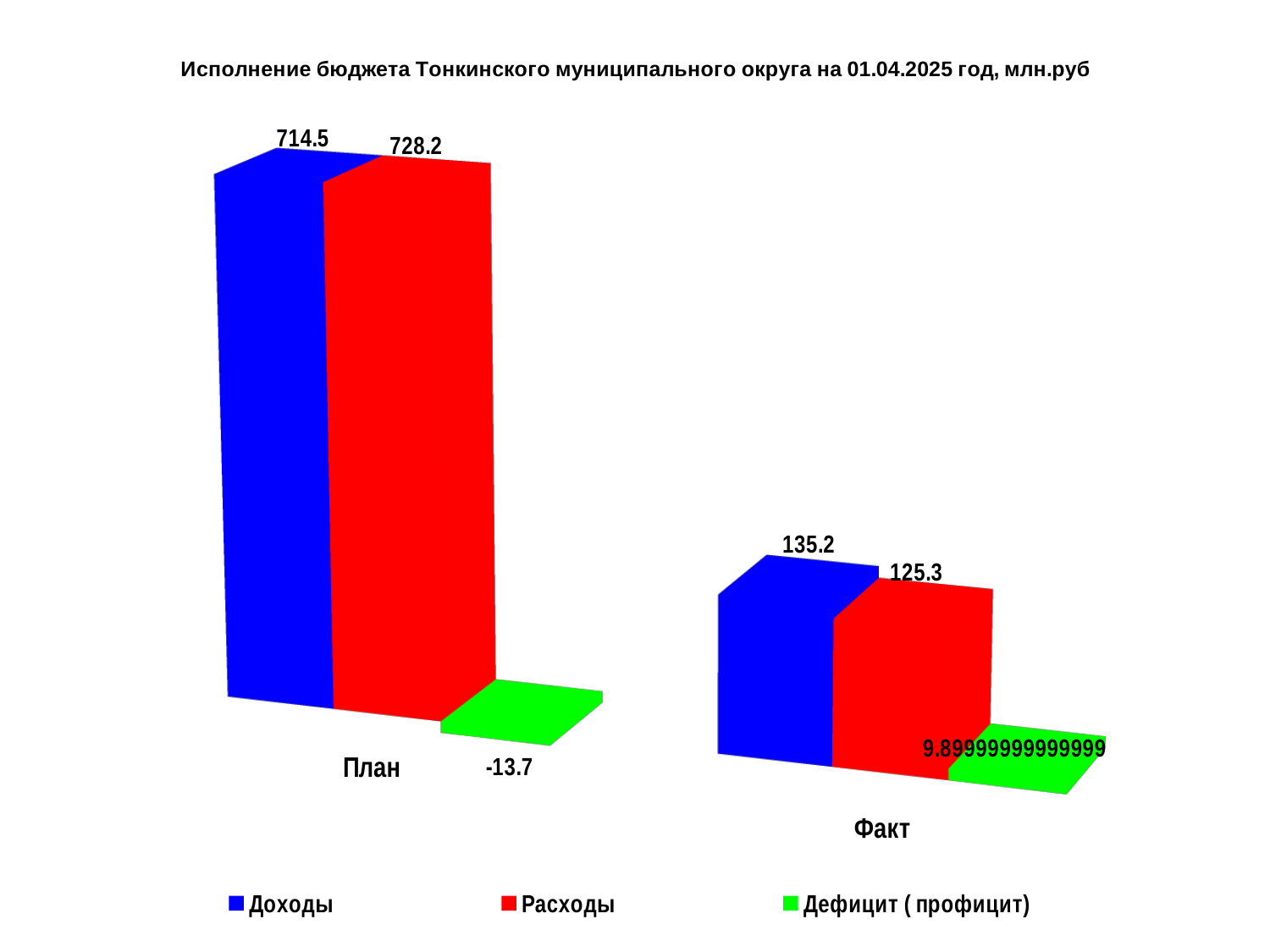
How many categories are shown on the x axis? 2 Which is larger for План: Доходы or Расходы? Расходы What is the value of Расходы for План? 728.2 What is the value of Доходы for Факт? 135.2 What is the value of Доходы for План? 714.5 How many series does the legend list? 3 What is the value of Дефицит ( профицит) for План? -13.7 What is the value of Расходы for Факт? 125.3 What is the difference between Доходы for План and Доходы for Факт? 579.3 What is the difference between Расходы and Доходы for План? 13.7 Which is larger for Факт: Доходы or Расходы? Доходы What kind of chart is shown on the slide? Bar chart